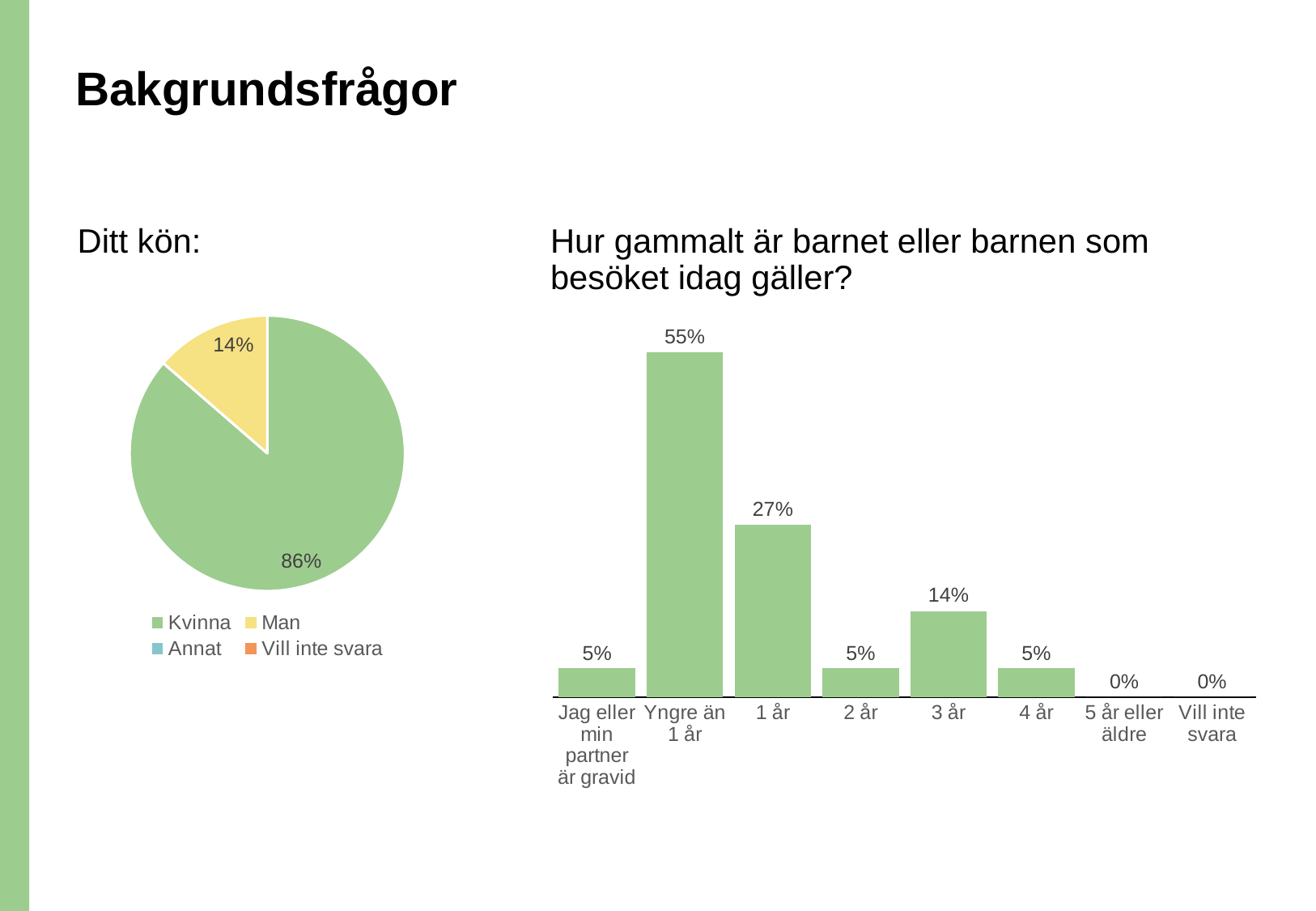
In the 'Ditt kön:' pie chart, how many entries does the legend list? 4 What kind of chart is the 'Hur gammalt är barnet eller barnen som besöket idag gäller?' chart? Bar chart In the 'Ditt kön:' pie chart, what share is Man? 14% In the 'Hur gammalt är barnet eller barnen som besöket idag gäller?' chart, what is the difference between 'Yngre än 1 år' and '1 år'? 28% In the 'Hur gammalt är barnet eller barnen som besöket idag gäller?' chart, which category has the highest value? Yngre än 1 år In the 'Hur gammalt är barnet eller barnen som besöket idag gäller?' chart, what is the value for 'Yngre än 1 år'? 55% In the 'Hur gammalt är barnet eller barnen som besöket idag gäller?' chart, what is the value for '1 år'? 27% In the 'Ditt kön:' pie chart, which category has the largest slice? Kvinna In the 'Hur gammalt är barnet eller barnen som besöket idag gäller?' chart, what is the value for '3 år'? 14% In the 'Hur gammalt är barnet eller barnen som besöket idag gäller?' chart, how many categories are shown on the x axis? 8 In the 'Ditt kön:' pie chart, what share is Kvinna? 86% What kind of chart is the 'Ditt kön:' chart? Pie chart